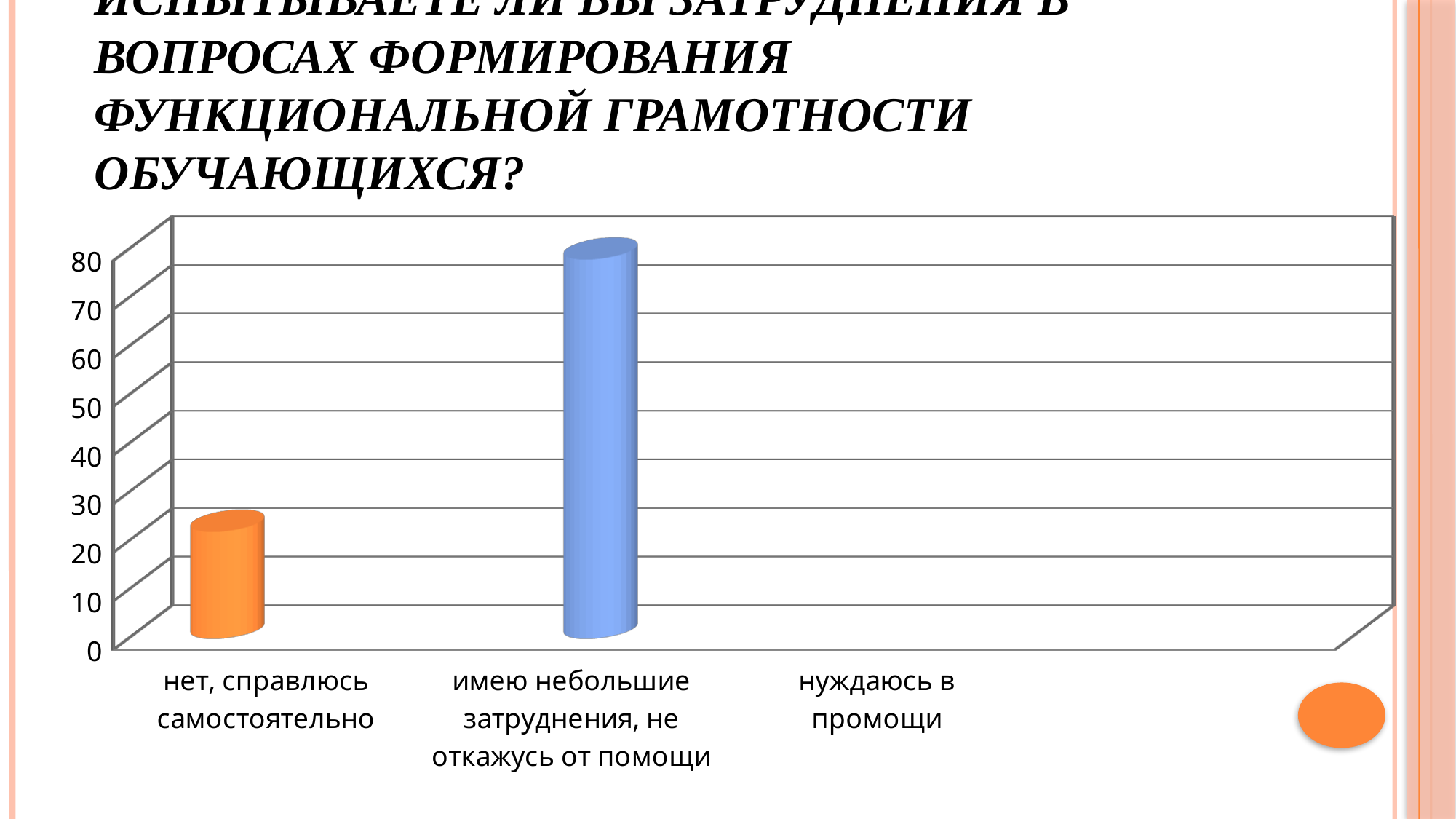
Is the value for "имею небольшие затруднения, не откажусь от помощи" greater or less than 70? greater Is the value for "имею небольшие затруднения, не откажусь от помощи" greater or less than 50? greater How many categories are shown on the x axis of the chart? 3 What kind of chart is shown on the slide? bar chart Is the value for "нет, справлюсь самостоятельно" greater or less than 10? greater Which category has the highest value in the chart? имею небольшие затруднения, не откажусь от помощи What is the highest value shown on the vertical axis of the chart? 80 What colour is the bar for "нет, справлюсь самостоятельно"? orange Which is larger: the value for "нет, справлюсь самостоятельно" or the value for "имею небольшие затруднения, не откажусь от помощи"? имею небольшие затруднения, не откажусь от помощи